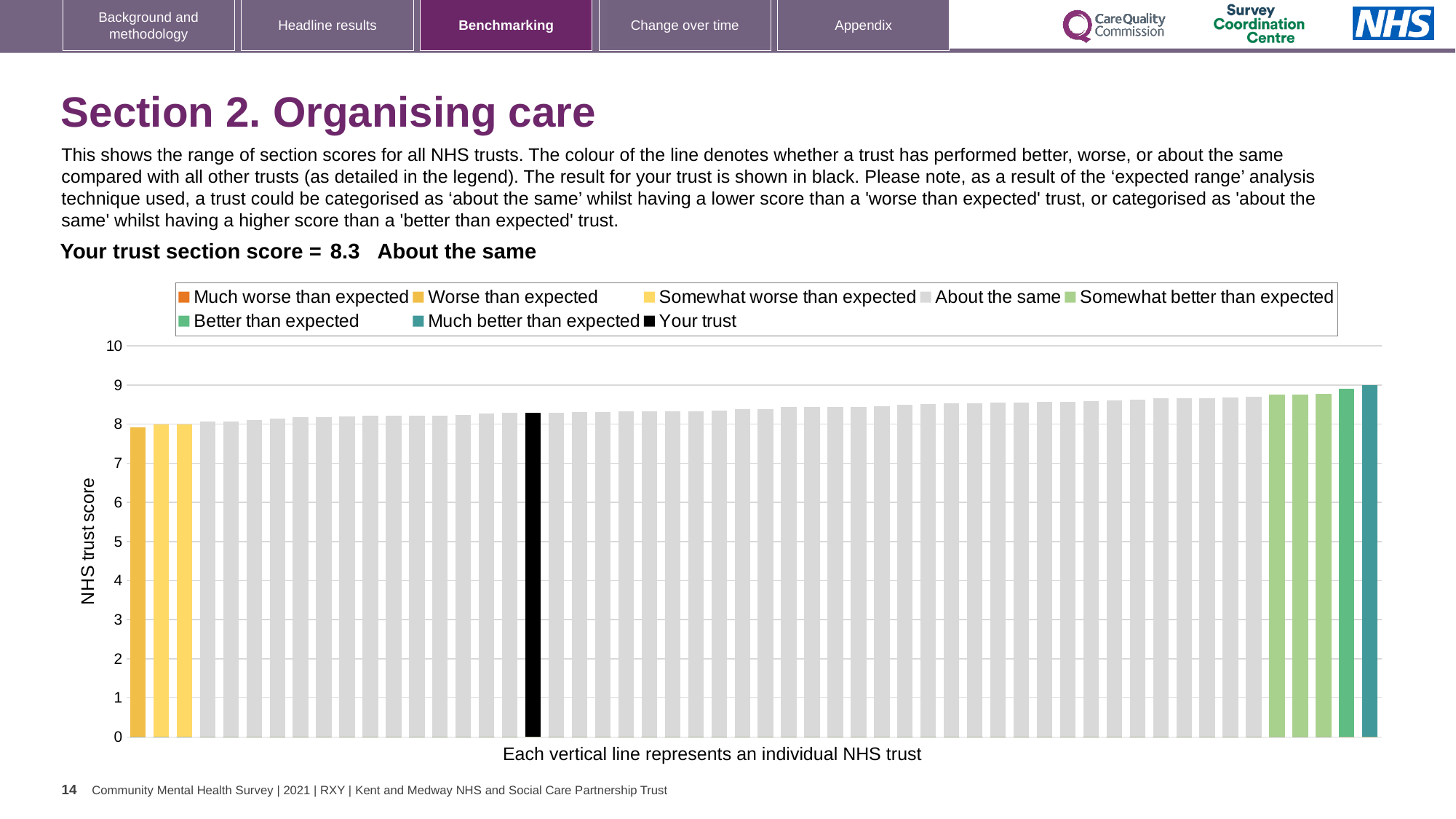
Which is larger, the rightmost bar or the leftmost bar? the rightmost bar Which is larger, the black 'Your trust' bar or the leftmost bar? the black 'Your trust' bar What is the label of the y axis? NHS trust score What kind of chart is shown on the slide? bar chart Is the value of the leftmost bar greater or less than 7? greater Is the value of the black 'Your trust' bar greater or less than 5? greater How many entries does the chart legend list? 8 What is the section score for your trust shown on the slide? 8.3 Do the bar values rise or fall from left to right along the x axis? rise What is the highest value shown on the y axis? 10 Which category is your trust placed in according to the text above the chart? About the same Is the value of the leftmost bar greater or less than 9? less